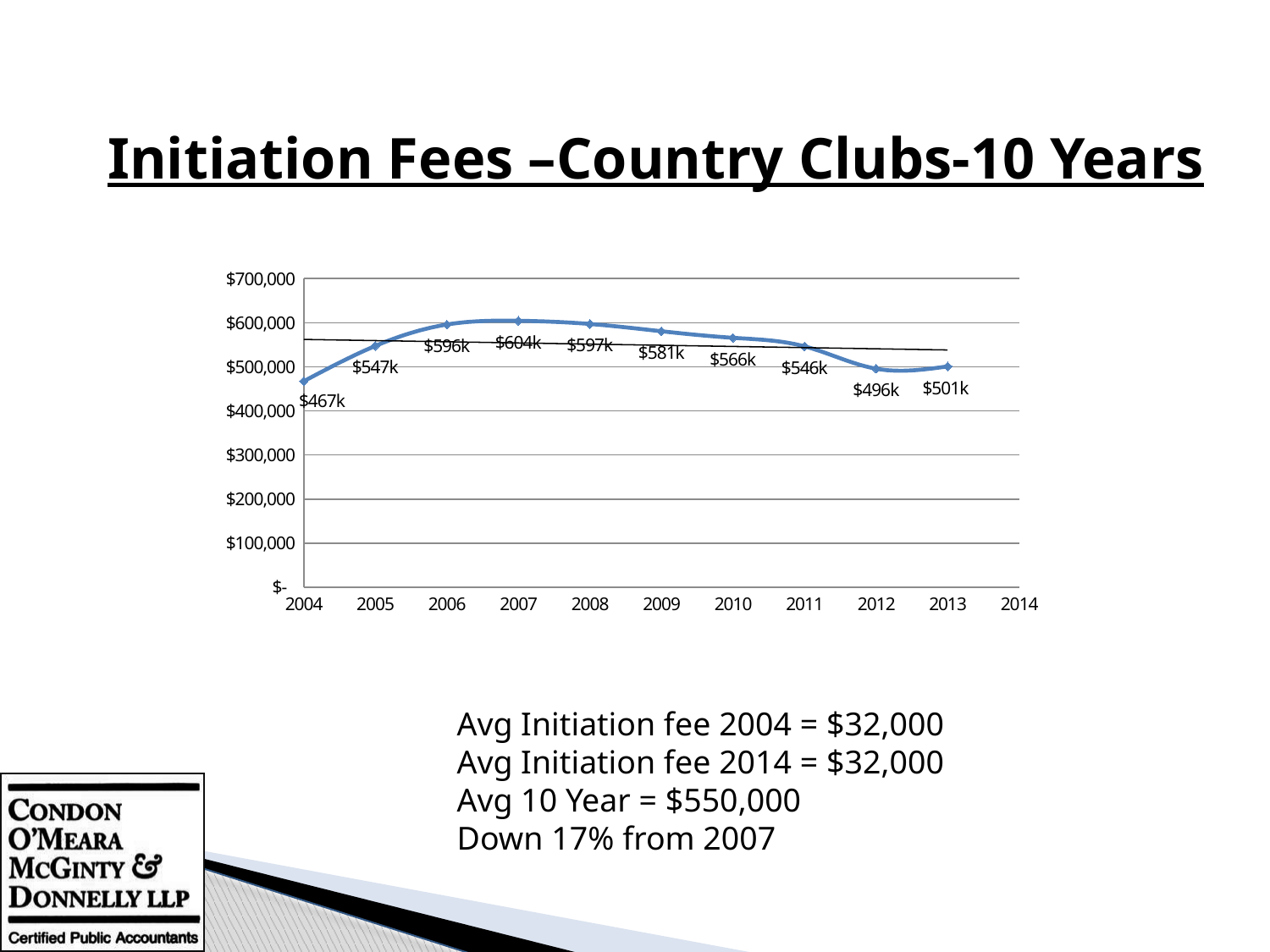
Which year has the highest initiation fee value? 2007 What is the initiation fee value for 2012? $496k What is the title of the slide containing the chart? Initiation Fees –Country Clubs-10 Years Which is larger, the value for 2005 or the value for 2011? 2005 What type of chart is shown on the slide? Line chart How many years have data points plotted on the line? 10 Is the value for 2009 greater or less than $500,000? greater Do the values rise or fall from 2007 to 2012? Fall What is the difference between the 2007 value and the 2013 value? $103k Which year has the lowest initiation fee value? 2004 What is the initiation fee value for 2004? $467k What is the initiation fee value for 2007? $604k